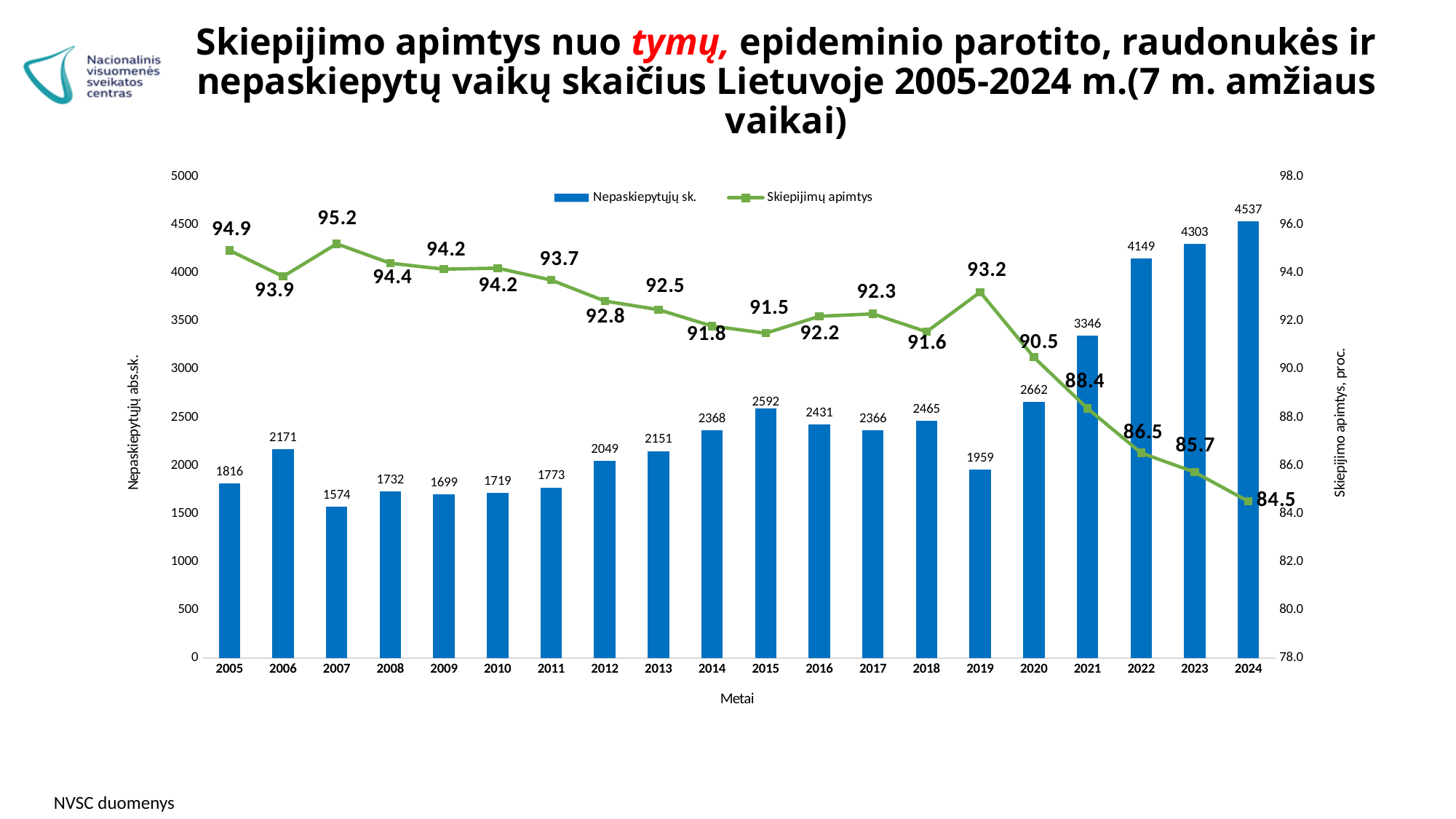
What is the Skiepijimų apimtys value for 2007? 95.2 How many years are shown on the x axis? 20 Which year has the lowest Skiepijimų apimtys value? 2024 Which year has the lowest Nepaskiepytųjų sk. value? 2007 Which is larger, the Nepaskiepytųjų sk. value for 2015 or for 2016? 2015 What is the Nepaskiepytųjų sk. value for 2019? 1959 How many series does the legend list? 2 What is the difference between the Nepaskiepytųjų sk. values for 2024 and 2023? 234 Does the Skiepijimų apimtys line rise or fall from 2019 to 2024? Fall What kind of chart is used for the Nepaskiepytųjų sk. series? Bar chart Which year has the highest Nepaskiepytųjų sk. value? 2024 What is the value of Nepaskiepytųjų sk. for 2024? 4537